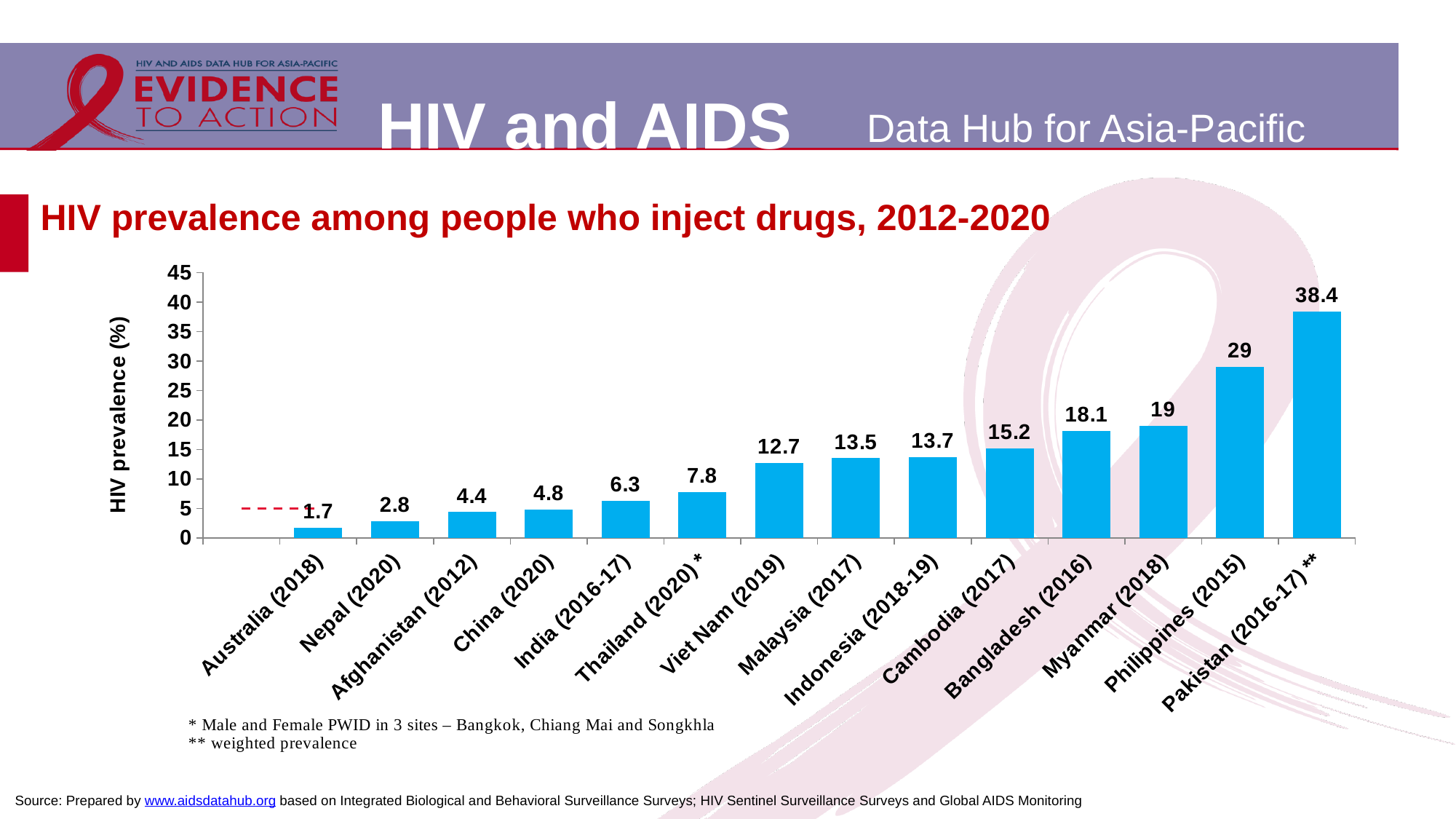
What is the HIV prevalence among people who inject drugs in Viet Nam (2019)? 12.7 Which has a higher HIV prevalence among people who inject drugs: Myanmar (2018) or Cambodia (2017)? Myanmar (2018) What is the label of the y-axis on the chart? HIV prevalence (%) What is the difference in HIV prevalence between Pakistan (2016-17) and Philippines (2015)? 9.4 What is the HIV prevalence among people who inject drugs in Bangladesh (2016)? 18.1 How many countries are shown on the chart? 14 Which country has the lowest HIV prevalence among people who inject drugs on the chart? Australia (2018) What is the HIV prevalence among people who inject drugs in Thailand (2020)? 7.8 Which country has the highest HIV prevalence among people who inject drugs on the chart? Pakistan (2016-17) Is the HIV prevalence for Philippines (2015) greater or less than 25? greater What type of chart is used to show HIV prevalence among people who inject drugs? Bar chart Do the values rise or fall from left to right across the chart? Rise